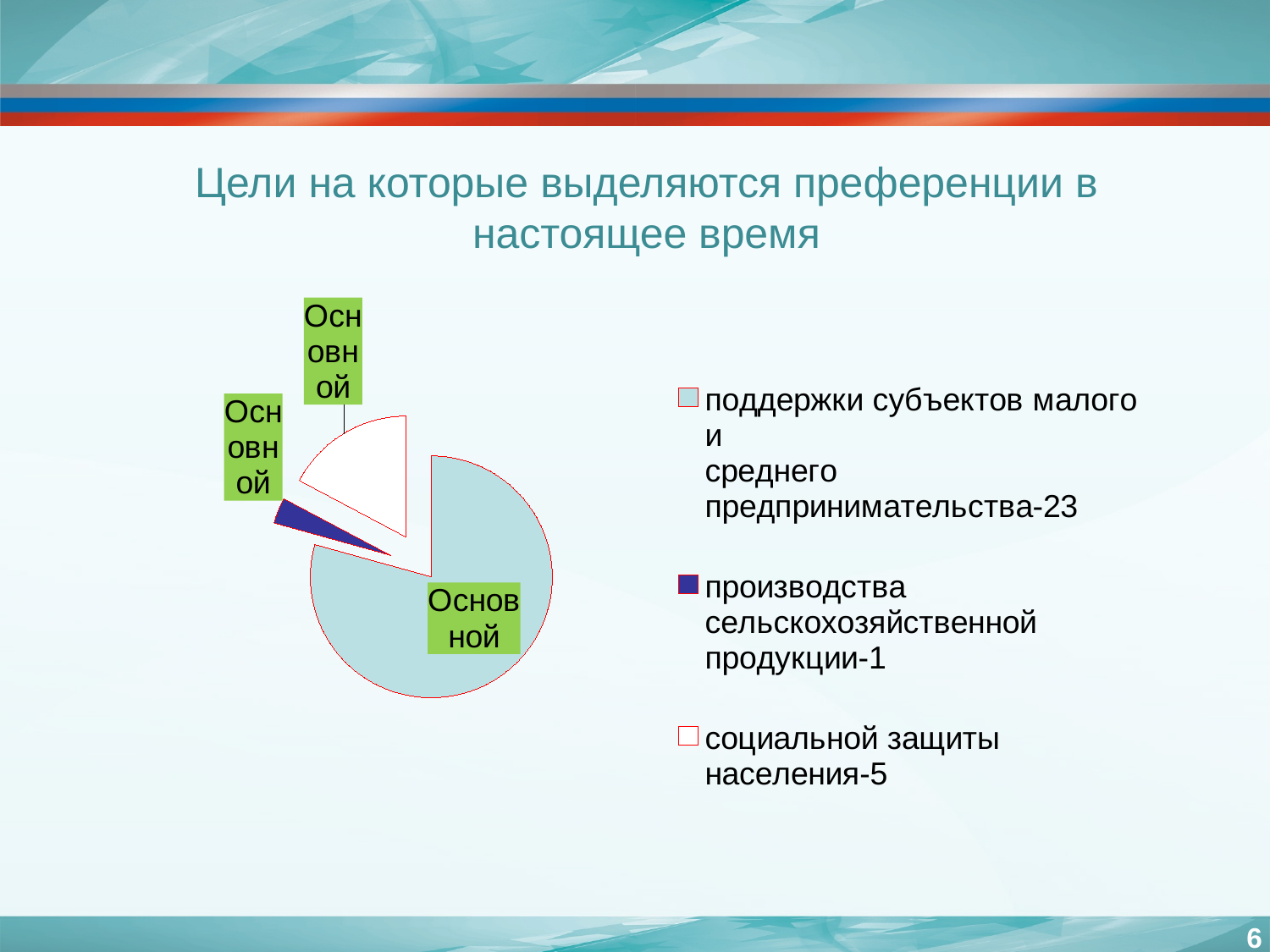
Which is larger: the value for социальной защиты населения or the value for производства сельскохозяйственной продукции? социальной защиты населения Which category has the smallest slice of the pie chart? производства сельскохозяйственной продукции How many entries does the legend of the pie chart list? 3 What colour is the largest slice of the pie chart? light blue What value is given in the legend for социальной защиты населения? 5 Which category has the largest slice of the pie chart? поддержки субъектов малого и среднего предпринимательства What value is given in the legend for поддержки субъектов малого и среднего предпринимательства? 23 What is the difference between the value for поддержки субъектов малого и среднего предпринимательства and the value for социальной защиты населения? 18 How many slices does the pie chart have? 3 What is the title of the slide containing the pie chart? Цели на которые выделяются преференции в настоящее время What kind of chart is shown on the slide? pie chart What value is given in the legend for производства сельскохозяйственной продукции? 1